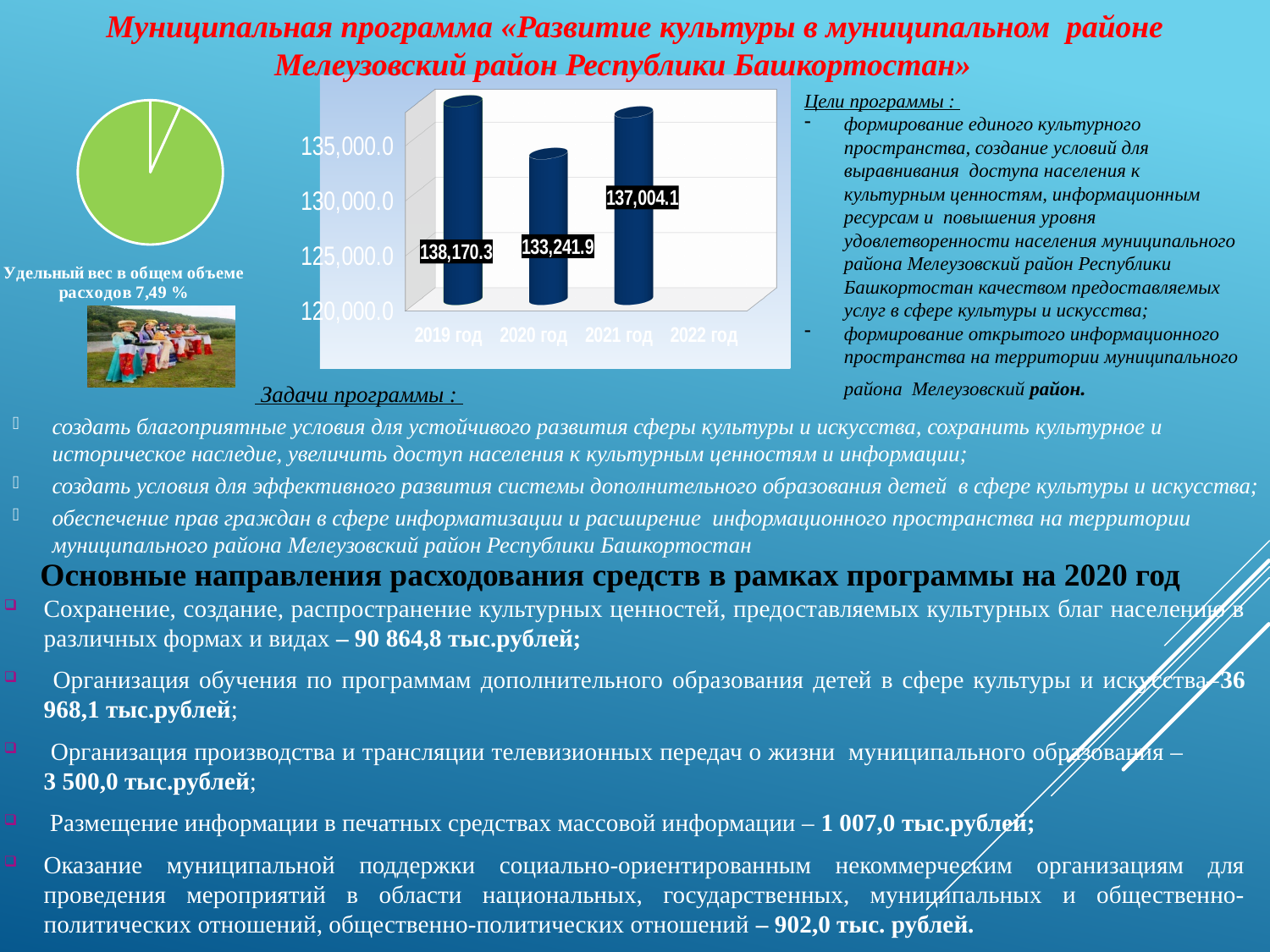
What kind of chart is the chart in the middle of the top of the slide? bar chart In the bar chart, is the value for 2020 год greater or less than 135,000.0? less In the bar chart, what is the value for 2021 год? 137,004.1 In the bar chart, what is the difference between the values for 2019 год and 2020 год? 4,928.4 In the bar chart, which year has the lowest value among the plotted bars? 2020 год In the pie chart on the left, what share does the small slice represent according to its caption? 7,49 % In the bar chart, which is larger: the value for 2021 год or the value for 2020 год? 2021 год What kind of chart is the chart on the left of the slide? pie chart In the bar chart, how many year labels are shown on the x axis? 4 In the bar chart, what is the value for 2019 год? 138,170.3 In the bar chart, what is the value for 2020 год? 133,241.9 In the bar chart, which year has the highest value? 2019 год